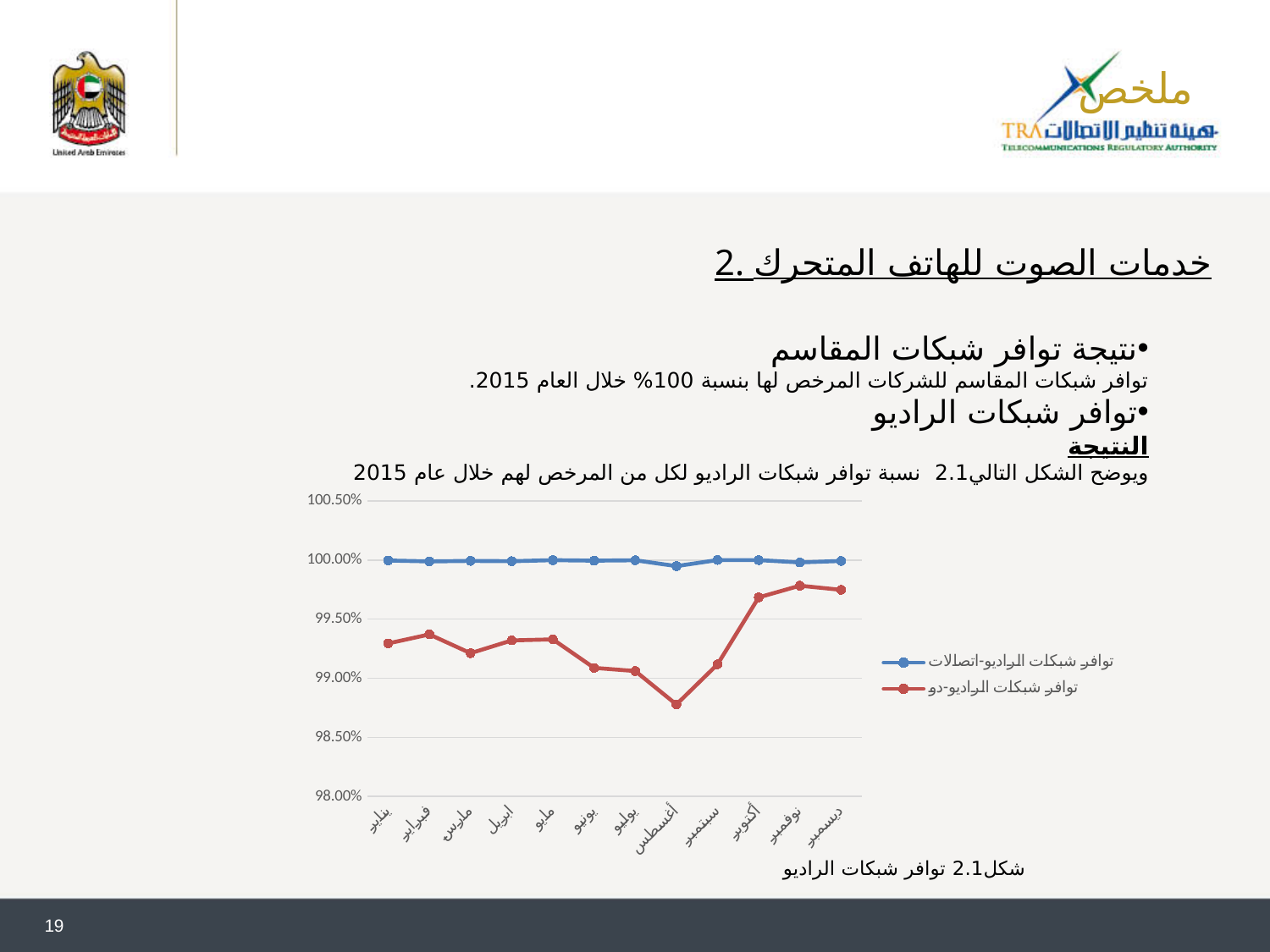
Which series is drawn in blue in the chart? توافر شبكات الراديو-اتصالات Is the value for توافر شبكات الراديو-دو in أغسطس greater or less than 99.00%? less Is the value for توافر شبكات الراديو-اتصالات in مارس greater or less than 99.50%? greater Does the value for توافر شبكات الراديو-دو rise or fall from أغسطس to نوفمبر? rise Is the value for توافر شبكات الراديو-دو in نوفمبر greater or less than 99.50%? greater What kind of chart is shown on the slide? line chart How many series does the chart legend list? 2 In which month is the value for توافر شبكات الراديو-دو lowest? أغسطس Which series has the higher value in يوليو, توافر شبكات الراديو-اتصالات or توافر شبكات الراديو-دو? توافر شبكات الراديو-اتصالات Which series is drawn in red in the chart? توافر شبكات الراديو-دو How many months are shown along the x axis of the chart? 12